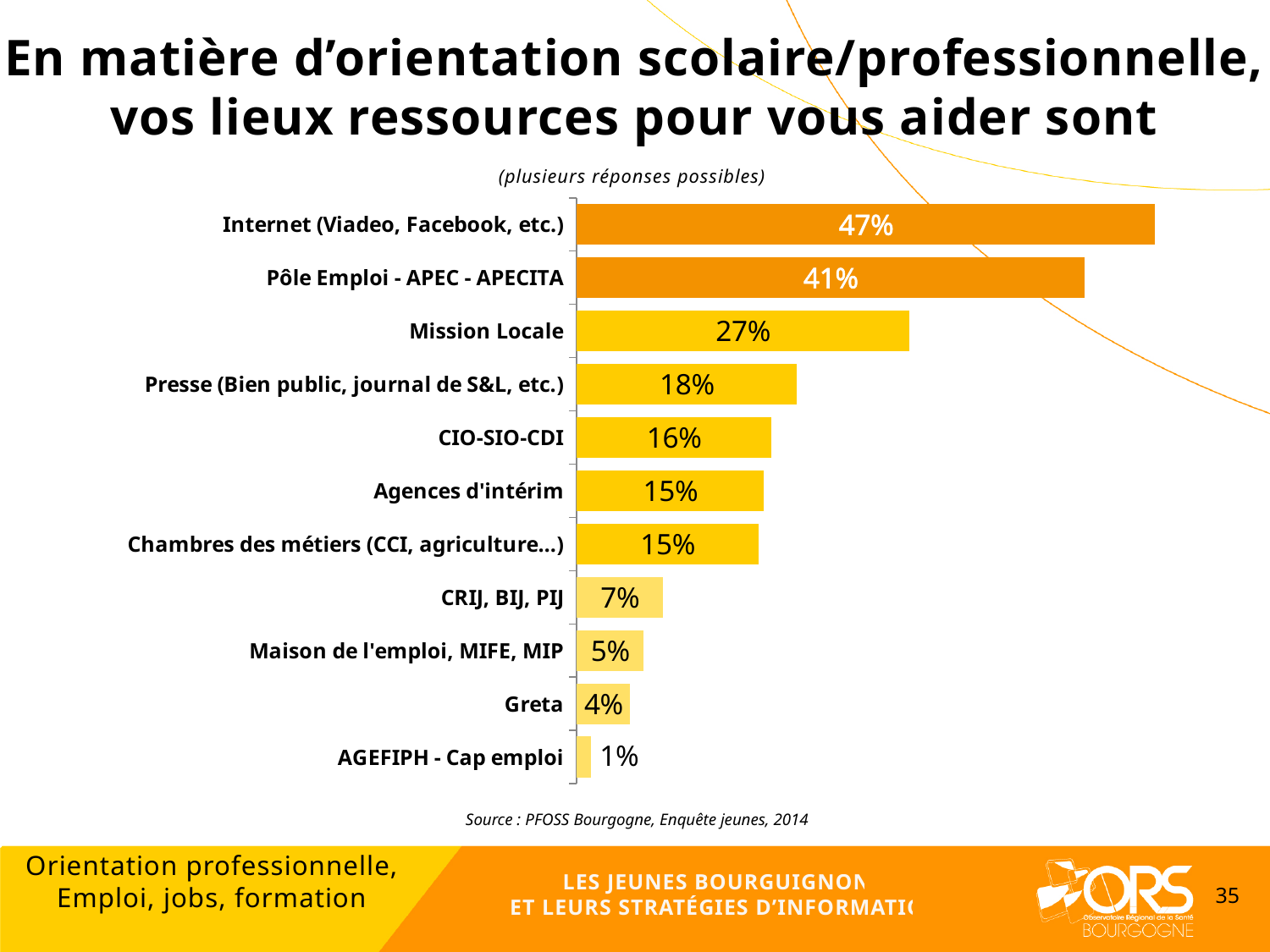
What is the difference between Mission Locale and Presse (Bien public, journal de S&L, etc.)? 9 percentage points What type of chart is shown on the slide? Bar chart What is the difference in percentage points between Internet (Viadeo, Facebook, etc.) and Pôle Emploi - APEC - APECITA? 6 percentage points What is the source cited below the chart? PFOSS Bourgogne, Enquête jeunes, 2014 How many resource categories are shown in the chart? 11 What is the value for Greta? 4% What percentage is shown for CIO-SIO-CDI? 16% What is the value shown for Mission Locale? 27% Which is larger: the value for CRIJ, BIJ, PIJ or the value for Maison de l'emploi, MIFE, MIP? CRIJ, BIJ, PIJ Which resource has the lowest percentage? AGEFIPH - Cap emploi Which resource has the highest percentage? Internet (Viadeo, Facebook, etc.) What percentage of respondents cited Internet (Viadeo, Facebook, etc.) as a resource? 47%